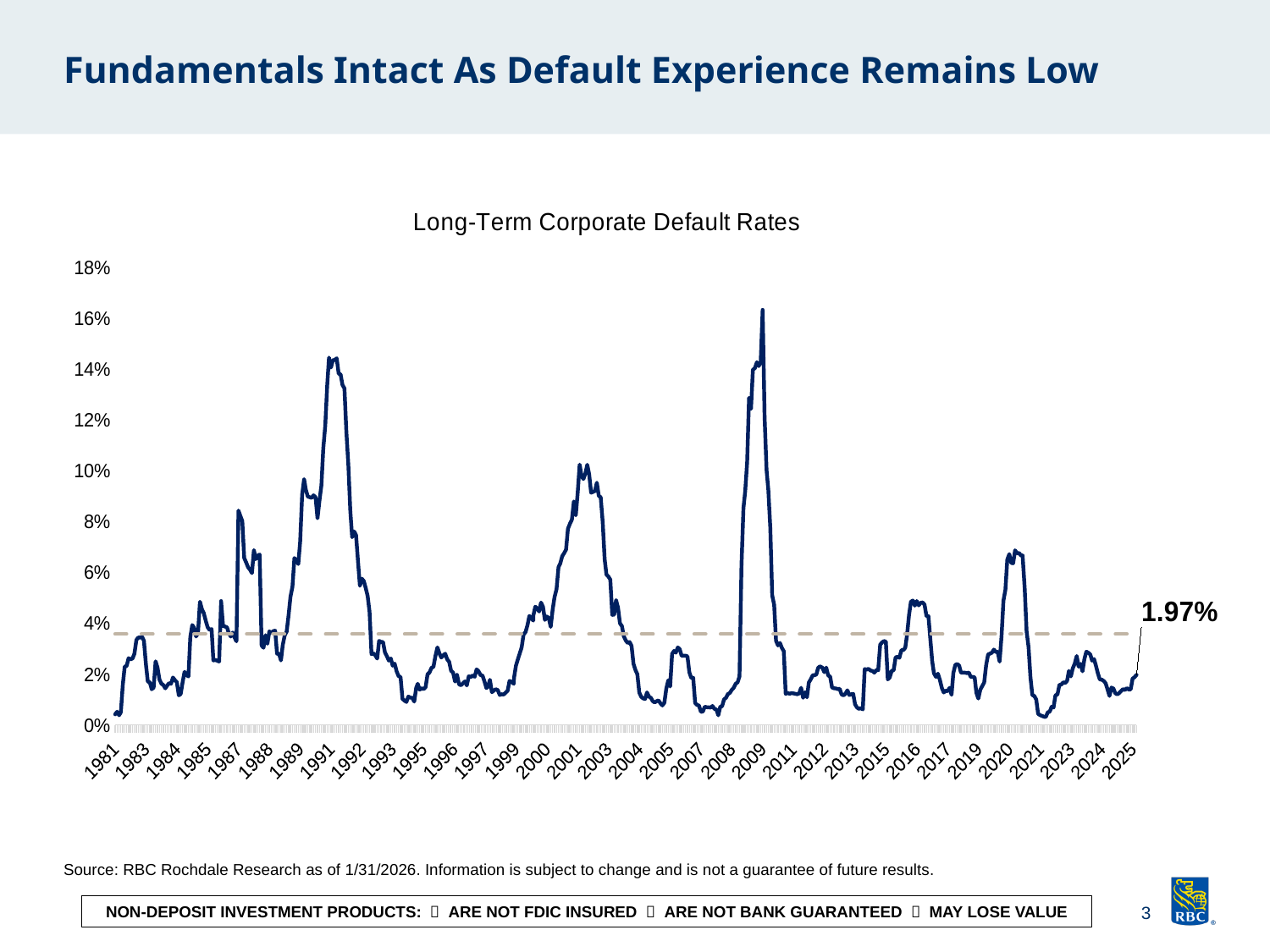
Is the latest labeled value of 1.97% greater or less than 4%? less Which peak is higher, the one around 1991 or the one around 2001? 1991 Is the peak default rate around 1991 greater or less than 12%? greater Is the peak default rate around 2009 greater or less than 14%? greater What is the highest value shown on the vertical axis? 18% Around which year does the default rate reach its highest peak? 2009 Does the default rate rise or fall from its 2009 peak to 2011? fall What kind of chart is shown on the slide? line chart What is the most recent default rate value labeled at the end of the line? 1.97% What is the title of the chart? Long-Term Corporate Default Rates